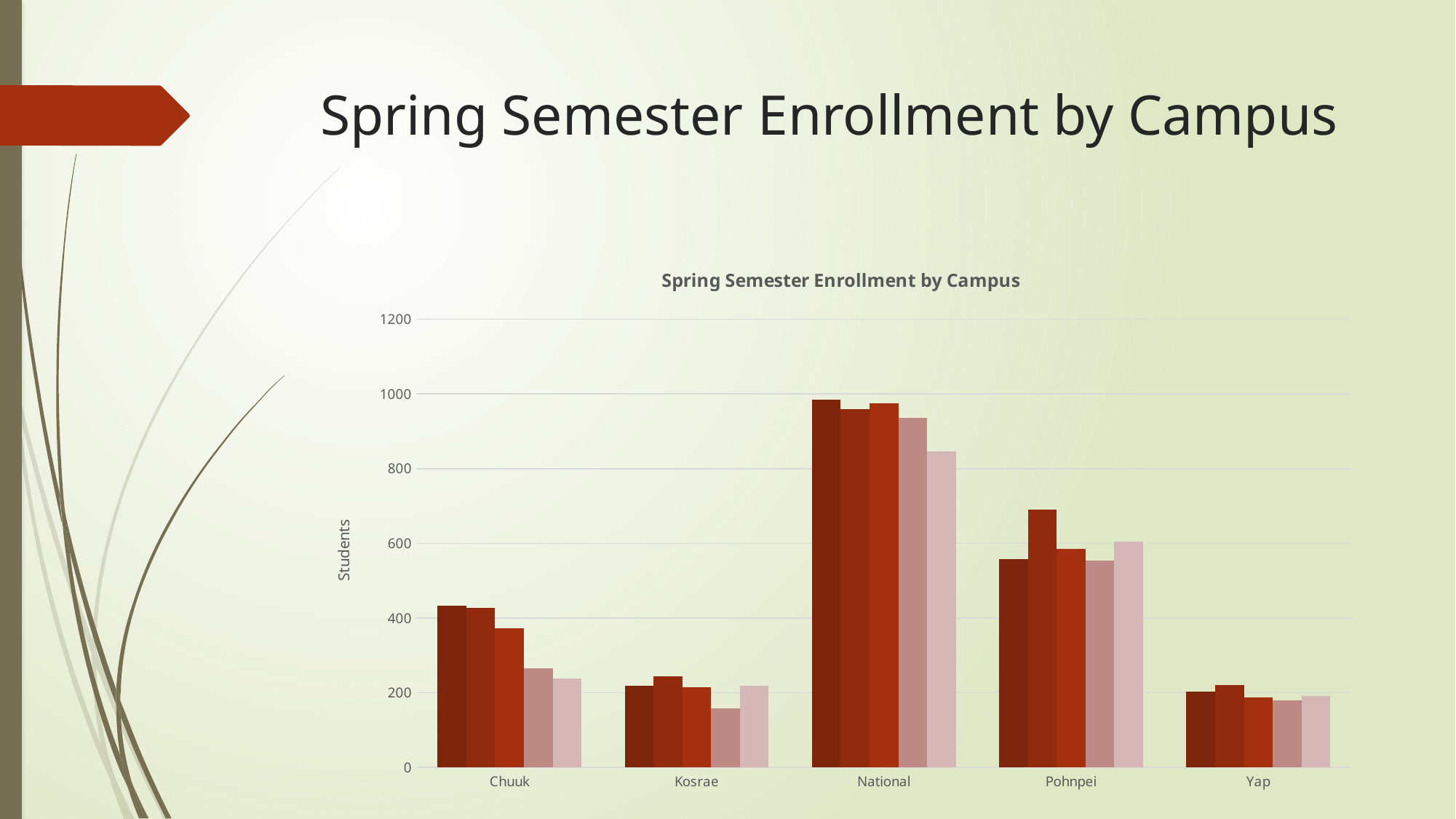
Which campus has higher enrollment, Pohnpei or Chuuk? Pohnpei Is the value of the tallest bar for Yap greater or less than 400? less Is the value of the tallest bar for National greater or less than 800? greater Is the value of the tallest bar for Kosrae greater or less than 400? less How many bars are plotted for each campus in the chart? 5 What kind of chart is shown on the slide? bar chart Which campus has the highest enrollment in the chart? National What is the label on the vertical axis of the chart? Students What is the title of the chart? Spring Semester Enrollment by Campus How many campuses are shown on the x axis of the chart? 5